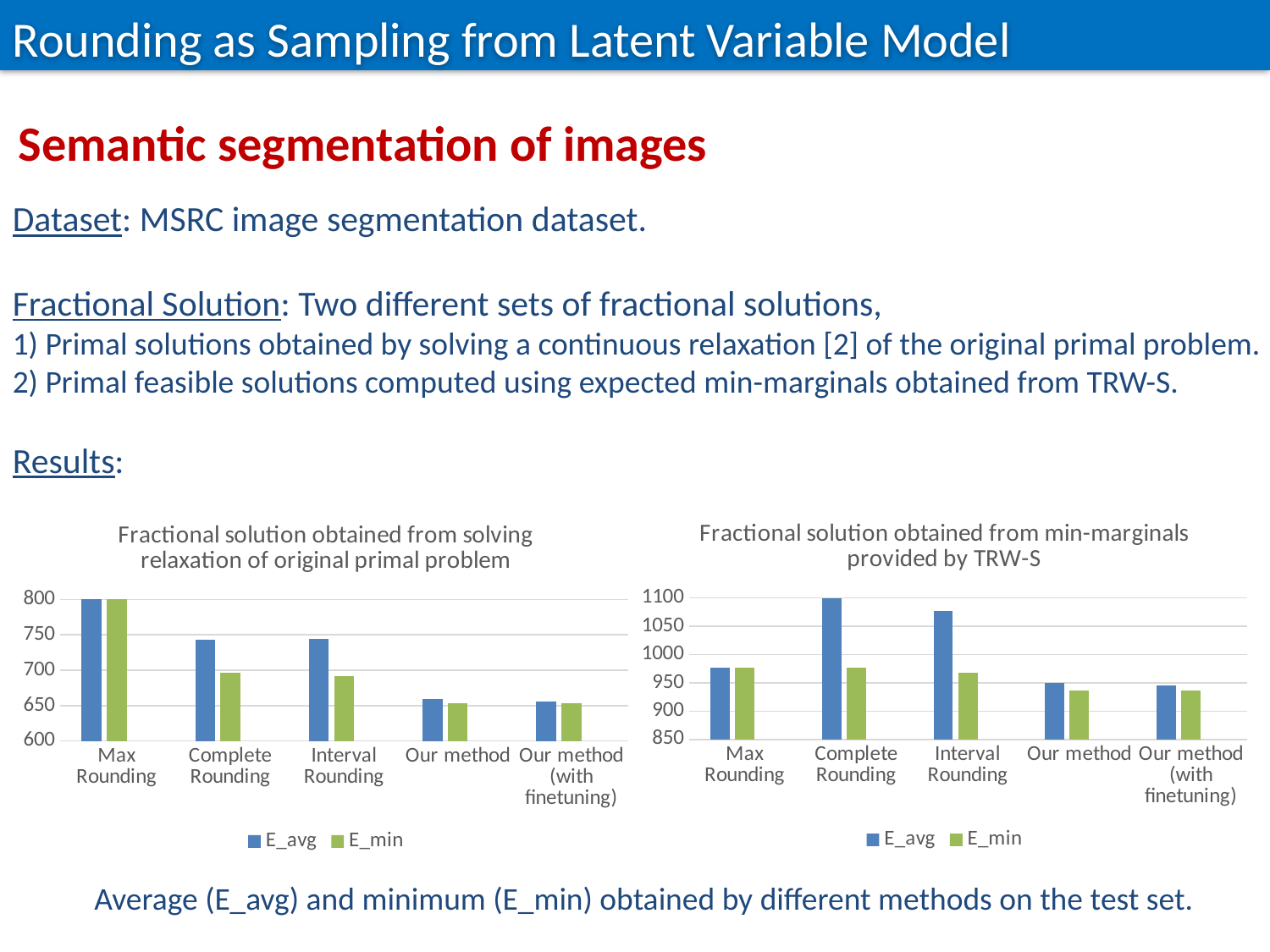
What are the two legend entries in the left chart (relaxation of original primal problem)? E_avg and E_min In the right chart (min-marginals provided by TRW-S), is the E_avg value for Interval Rounding greater or less than 1050? greater In the right chart (min-marginals provided by TRW-S), is the E_min value for Our method greater or less than 950? less In the left chart (relaxation of original primal problem), how many method categories are shown on the x axis? 5 What kind of chart is the left chart titled 'Fractional solution obtained from solving relaxation of original primal problem'? bar chart In the right chart (min-marginals provided by TRW-S), which has the larger E_avg value: Max Rounding or Interval Rounding? Interval Rounding In the right chart (Fractional solution obtained from min-marginals provided by TRW-S), how many series does the legend list? 2 In the left chart (relaxation of original primal problem), which method has the highest E_avg value? Max Rounding In the left chart (relaxation of original primal problem), is the E_avg value for Complete Rounding greater or less than 700? greater In the right chart (min-marginals provided by TRW-S), which method has the highest E_avg value? Complete Rounding In the left chart (relaxation of original primal problem), which has the larger E_avg value: Complete Rounding or Our method? Complete Rounding